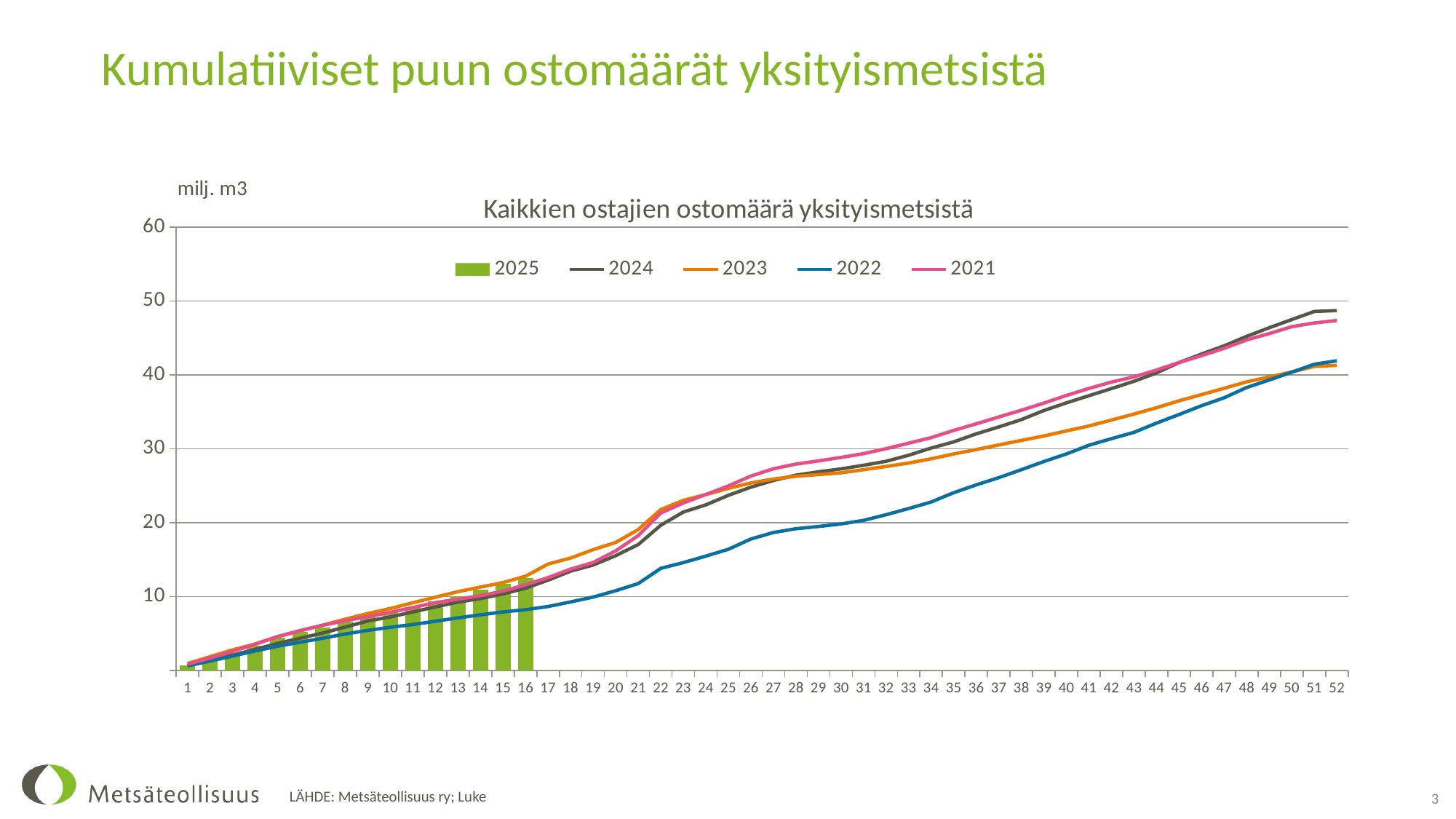
How many series does the legend list? 5 How many weeks are shown on the x axis? 52 What kind of chart is this? A combination chart with bars (2025) and lines (2021–2024) Is the value for 2022 at week 22 greater or less than 20? less Is the value for 2021 at week 40 greater or less than 30? greater Is the value for 2024 at week 52 greater or less than 40? greater At week 30, which is larger: the value for 2021 or the value for 2022? 2021 Do the values of the 2024 line rise or fall along the x axis? rise Which series is lowest at week 30? 2022 What unit is shown on the y axis? milj. m3 For how many weeks are 2025 bars plotted? 16